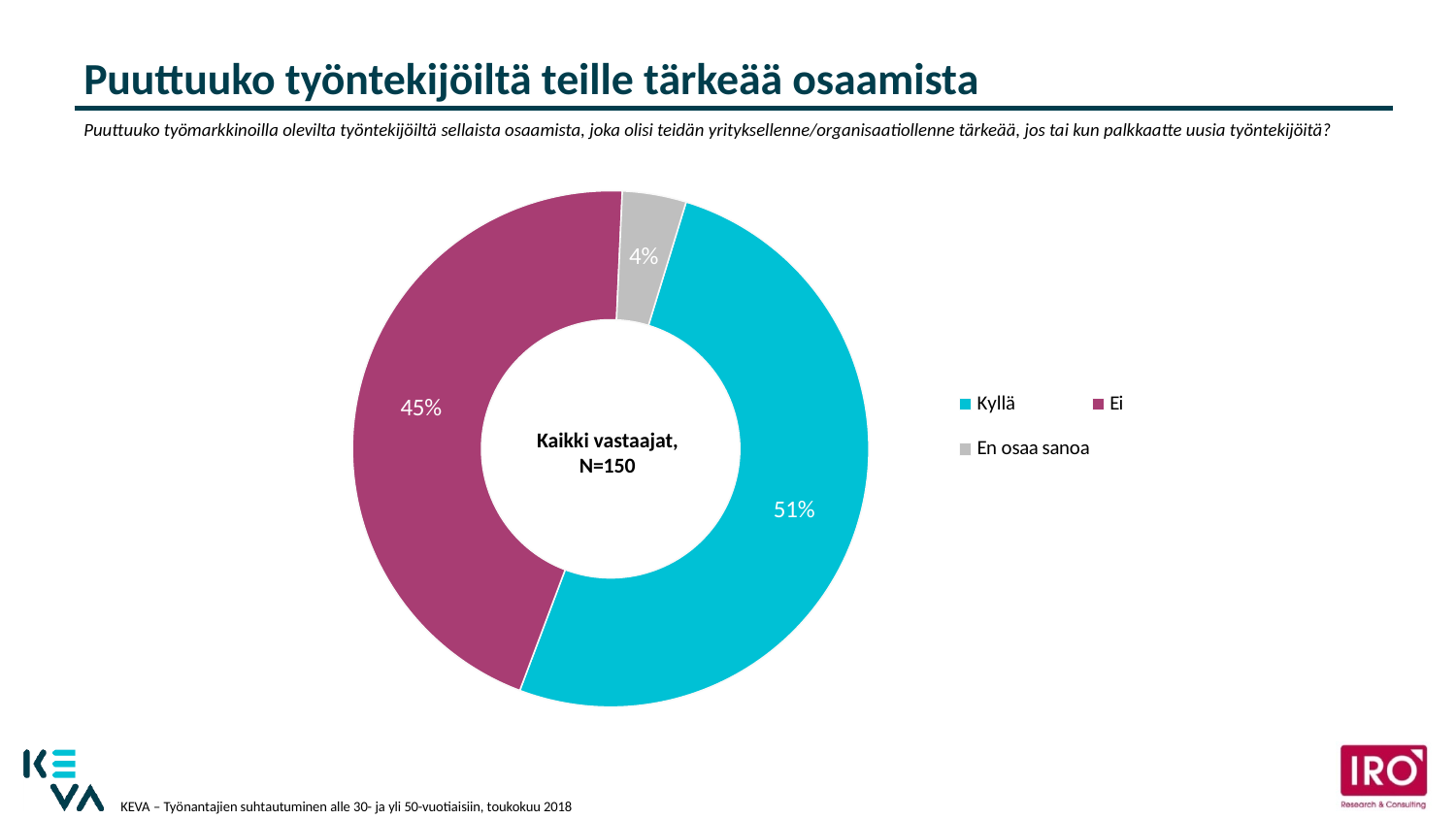
Which response category has the largest share? Kyllä What share of respondents answered "Ei"? 45% Which response category has the smallest share? En osaa sanoa Which is larger, the share for "Ei" or the share for "En osaa sanoa"? Ei What colour represents "Kyllä" in the chart? Cyan (light blue) How many categories does the chart show? 3 How many entries does the legend list? 3 What is the difference in percentage points between the "Kyllä" and "Ei" shares? 6 percentage points What text is shown in the centre of the chart? Kaikki vastaajat, N=150 What share of respondents answered "Kyllä"? 51% What kind of chart is shown on the slide? Doughnut (pie) chart What share of respondents answered "En osaa sanoa"? 4%